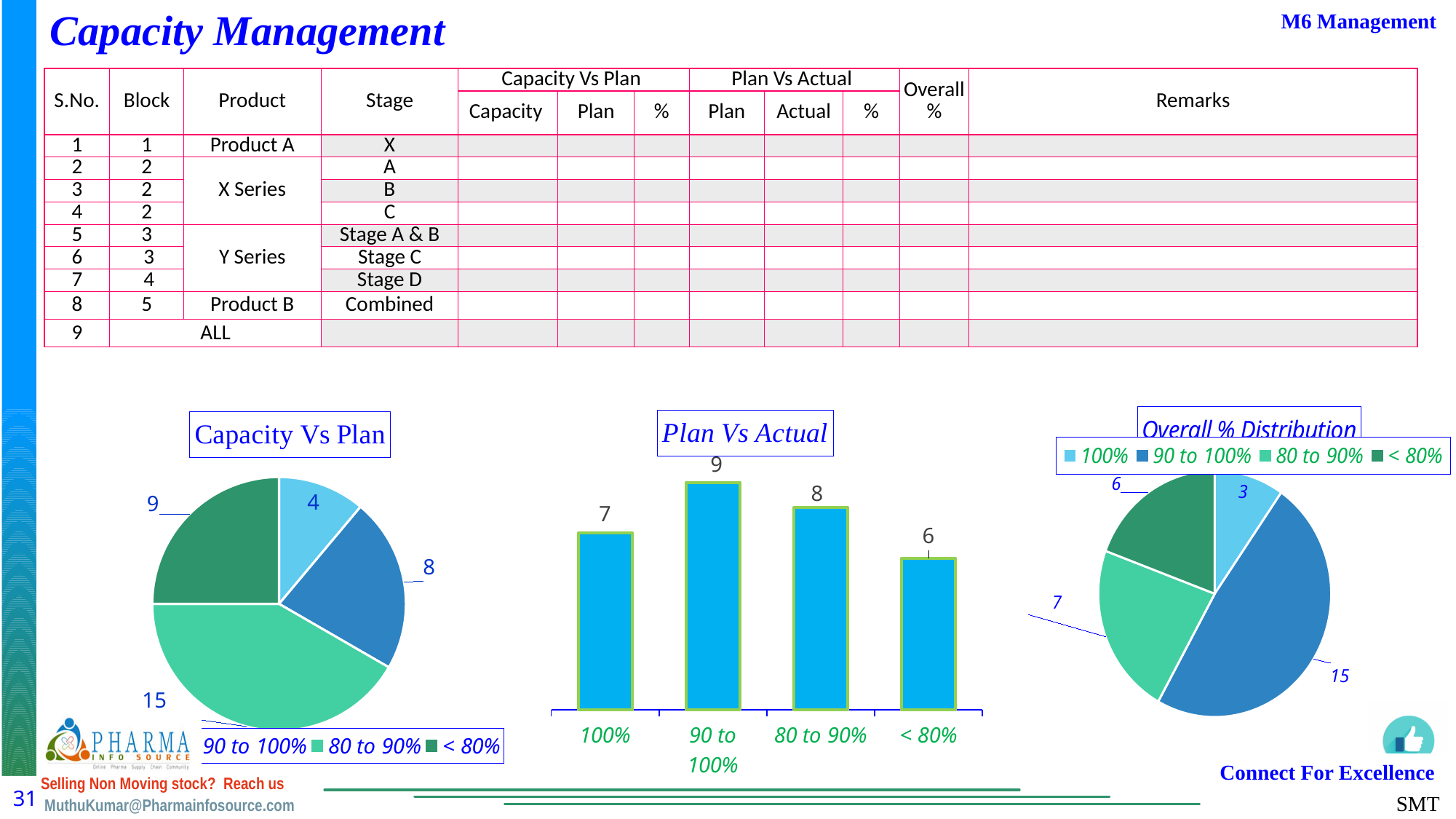
In the Plan Vs Actual chart, which category has the highest value? 90 to 100% In the Plan Vs Actual chart, which category has the lowest value? < 80% In the Overall % Distribution chart, what is the value for the 90 to 100% slice? 15 In the Capacity Vs Plan pie chart, what is the value of the largest slice? 15 In the Plan Vs Actual chart, what is the value for the < 80% category? 6 In the Overall % Distribution chart, which is larger, the 80 to 90% slice or the < 80% slice? 80 to 90% How many entries does the legend of the Overall % Distribution chart list? 4 In the Plan Vs Actual chart, what is the difference between the values for 100% and 80 to 90%? 1 How many bars are in the Plan Vs Actual chart? 4 In the Plan Vs Actual chart, what is the value for the 90 to 100% category? 9 What kind of chart is the Plan Vs Actual chart? Bar chart In the Overall % Distribution chart, what is the value for the 100% slice? 3